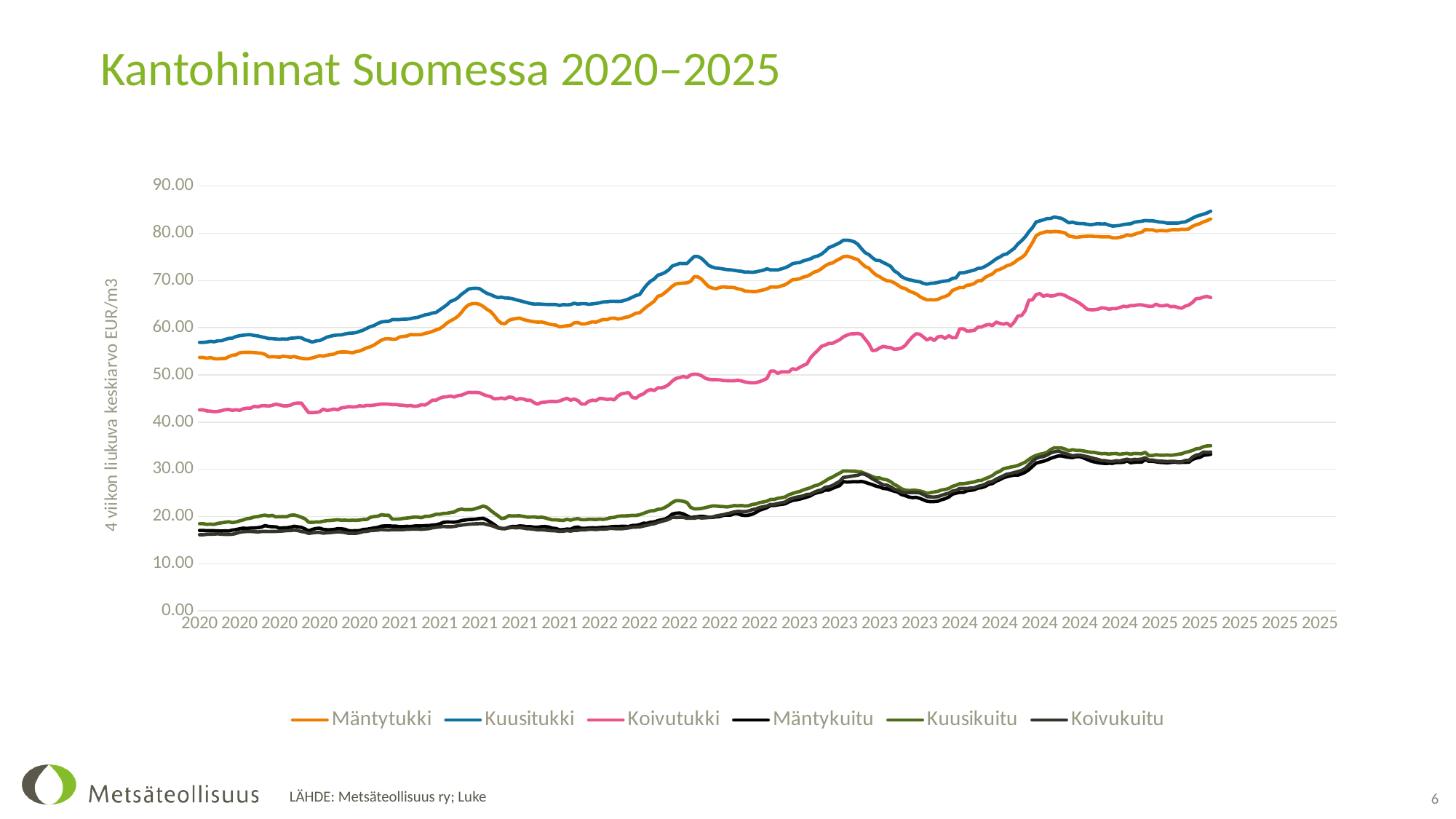
Is the value for Kuusitukki at the end of the series in 2025 greater or less than 80? greater Does the Kuusitukki line rise or fall overall from 2020 to 2025? rise Is the value for Mäntytukki at the start of 2020 greater or less than 60? less Is the value for Koivutukki at the start of 2020 greater or less than 50? less At the end of the series in 2025, which is larger: Koivutukki or Kuusikuitu? Koivutukki What is the label on the vertical axis? 4 viikon liukuva keskiarvo EUR/m3 Among the three kuitu series (Mäntykuitu, Kuusikuitu, Koivukuitu), which one has the highest values? Kuusikuitu How many series does the legend list? 6 Which series has the highest values across the whole period? Kuusitukki What kind of chart is shown on the slide? line chart What is the title of the chart? Kantohinnat Suomessa 2020–2025